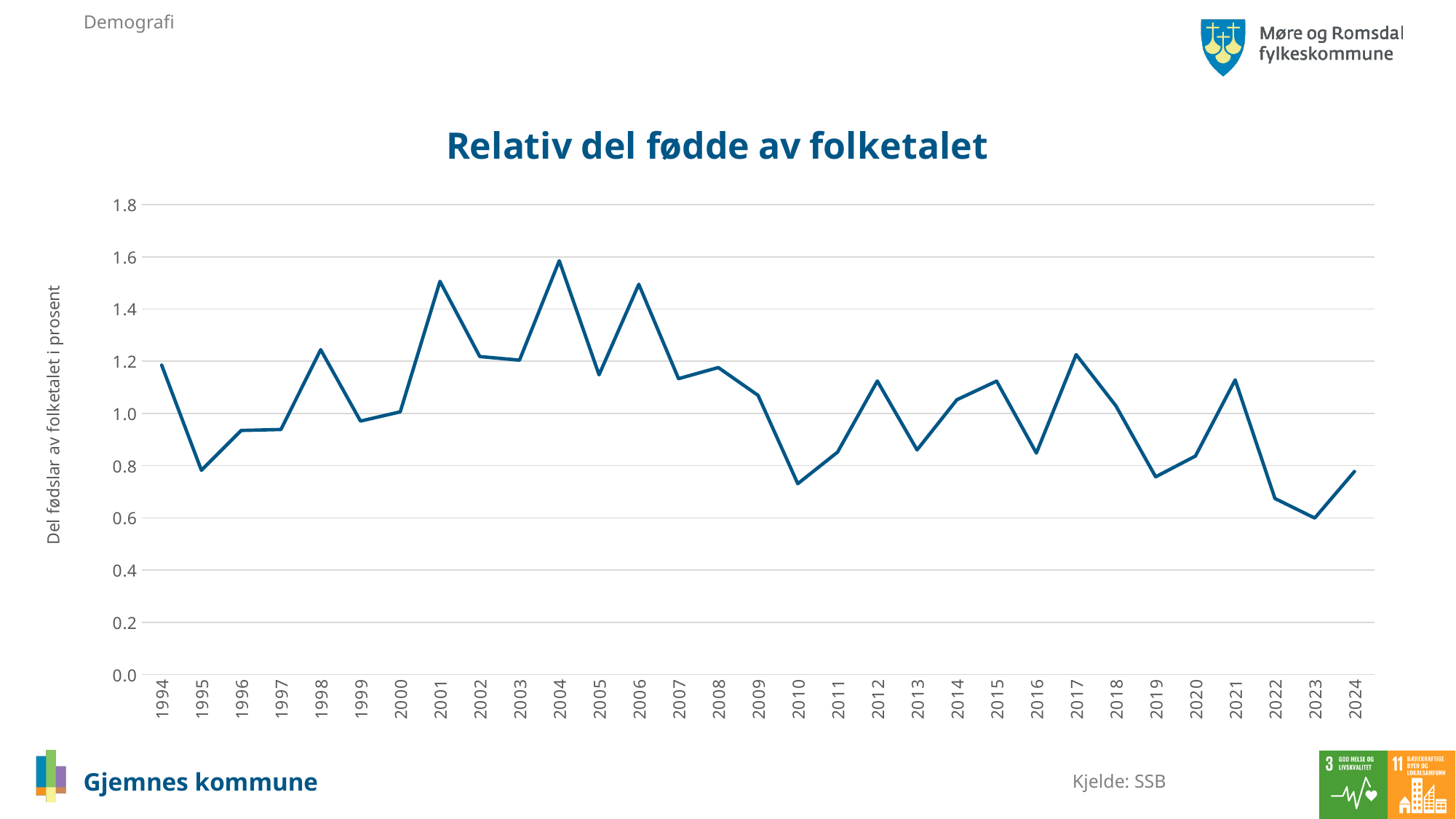
Which year has the higher value, 2004 or 2006? 2004 What kind of chart is shown on the slide? line chart In which year is the relative share of births lowest? 2023 What is the title of the chart? Relativ del fødde av folketalet Is the value for 1995 greater or less than 1.0? less How many years are plotted along the x axis of the chart? 31 Is the value for 2001 greater or less than 1.4? greater Is the value for 2004 greater or less than 1.4? greater What is the label on the vertical axis of the chart? Del fødslar av folketalet i prosent In which year is the relative share of births highest? 2004 Do the values rise or fall from 2021 to 2023? fall